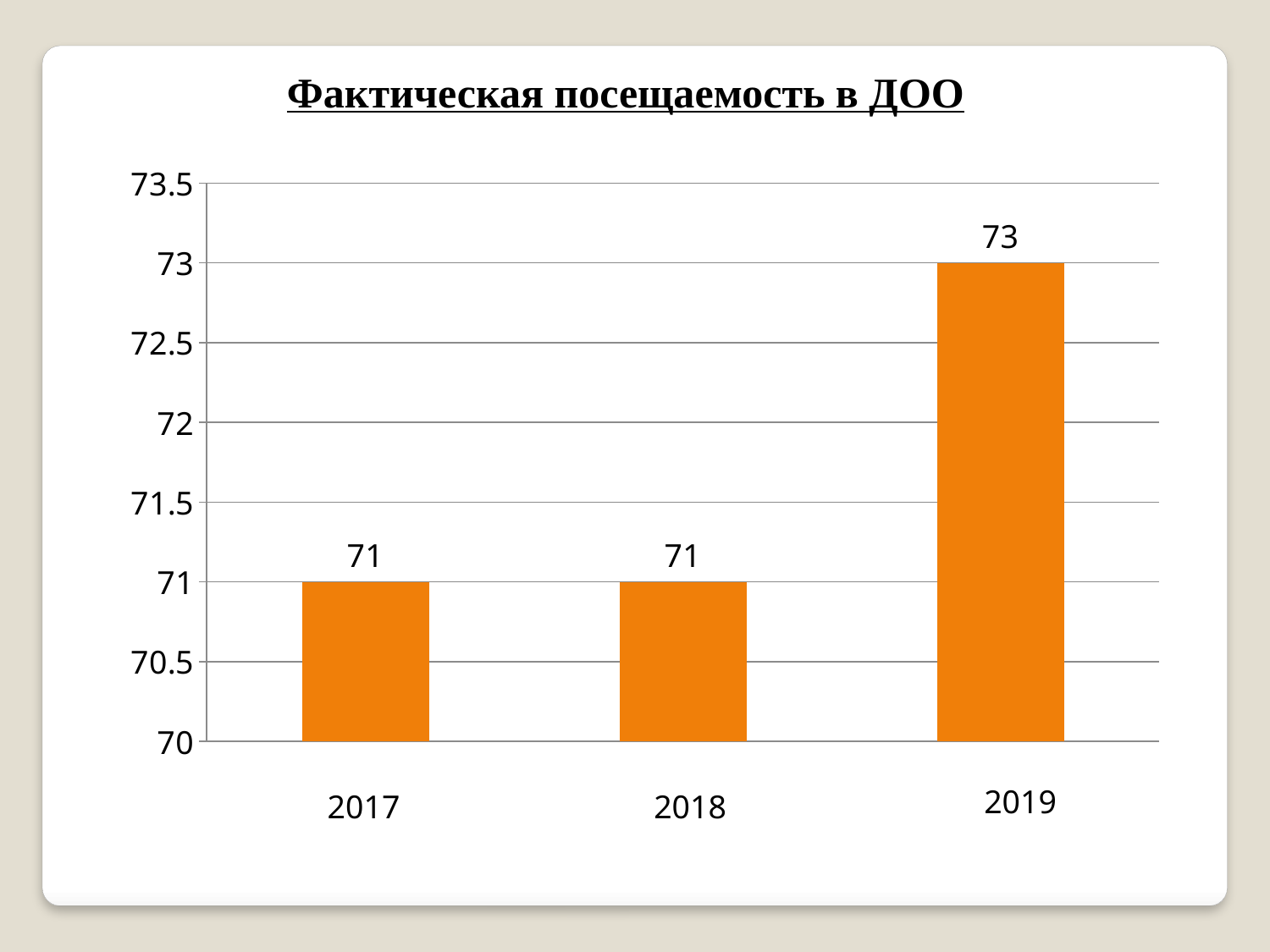
What is the value for 2018? 71 Which is larger, the value for 2019 or the value for 2017? 2019 Is the value for 2017 greater or less than 72? less What is the title of the chart? Фактическая посещаемость в ДОО Which year has the highest value? 2019 What kind of chart is shown on the slide? bar chart How many years are shown on the chart? 3 What is the difference between the values for 2019 and 2018? 2 What is the value for 2017? 71 What is the value for 2019? 73 Do the values rise or fall from 2018 to 2019? rise Is the value for 2019 greater or less than 72? greater